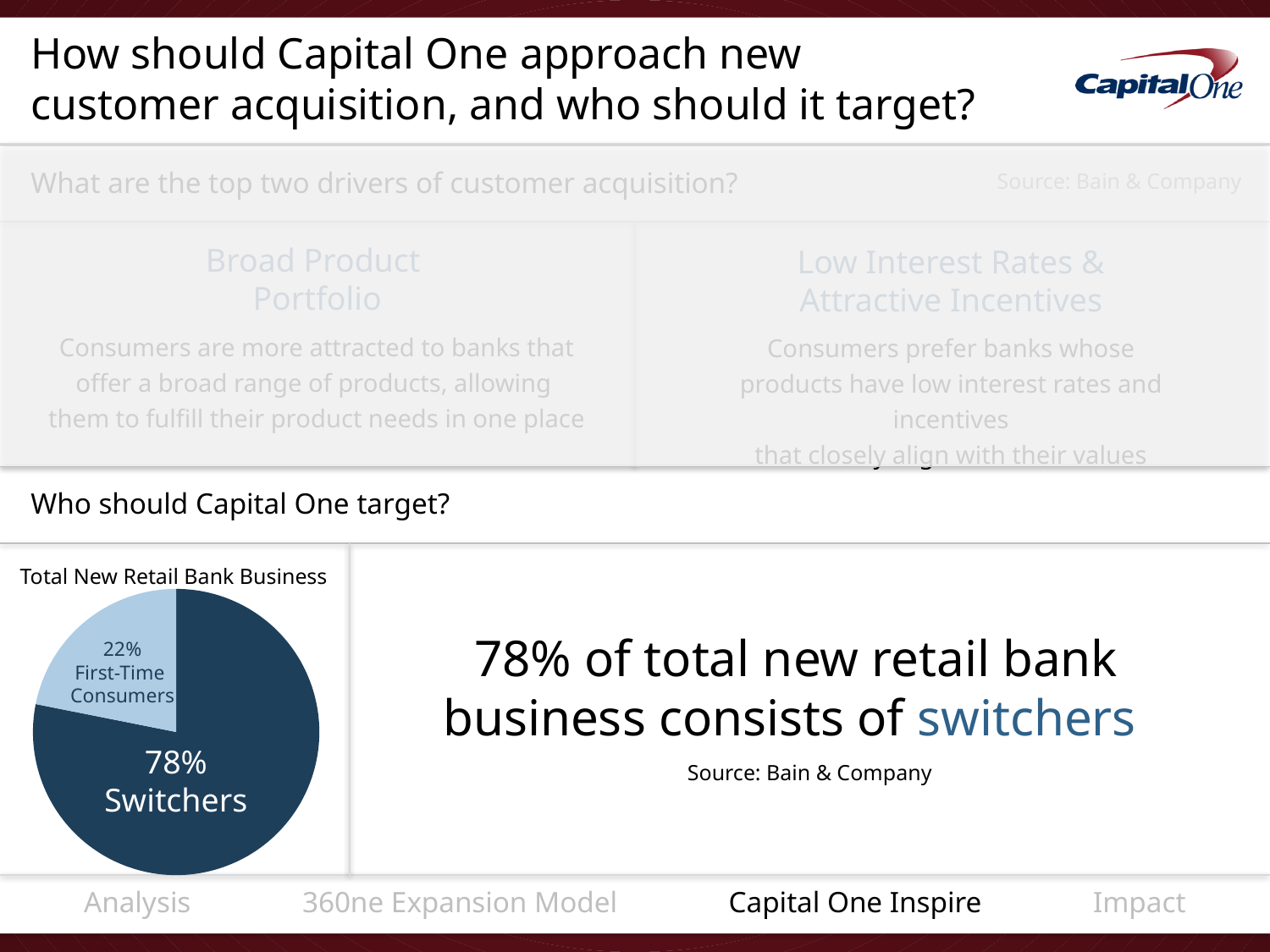
What is the total of the two slices shown in the pie chart? 100% Which is larger: the Switchers slice or the First-Time Consumers slice? Switchers How many slices does the pie chart have? 2 What colour is the Switchers slice of the pie chart? dark blue Which slice of the pie chart is the smallest? First-Time Consumers What is the title of the pie chart? Total New Retail Bank Business What share of total new retail bank business is made up of First-Time Consumers? 22% What kind of chart is shown on the slide? pie chart Which slice of the pie chart is the largest? Switchers What share of total new retail bank business is made up of Switchers? 78% What is the difference in percentage points between the Switchers slice and the First-Time Consumers slice? 56